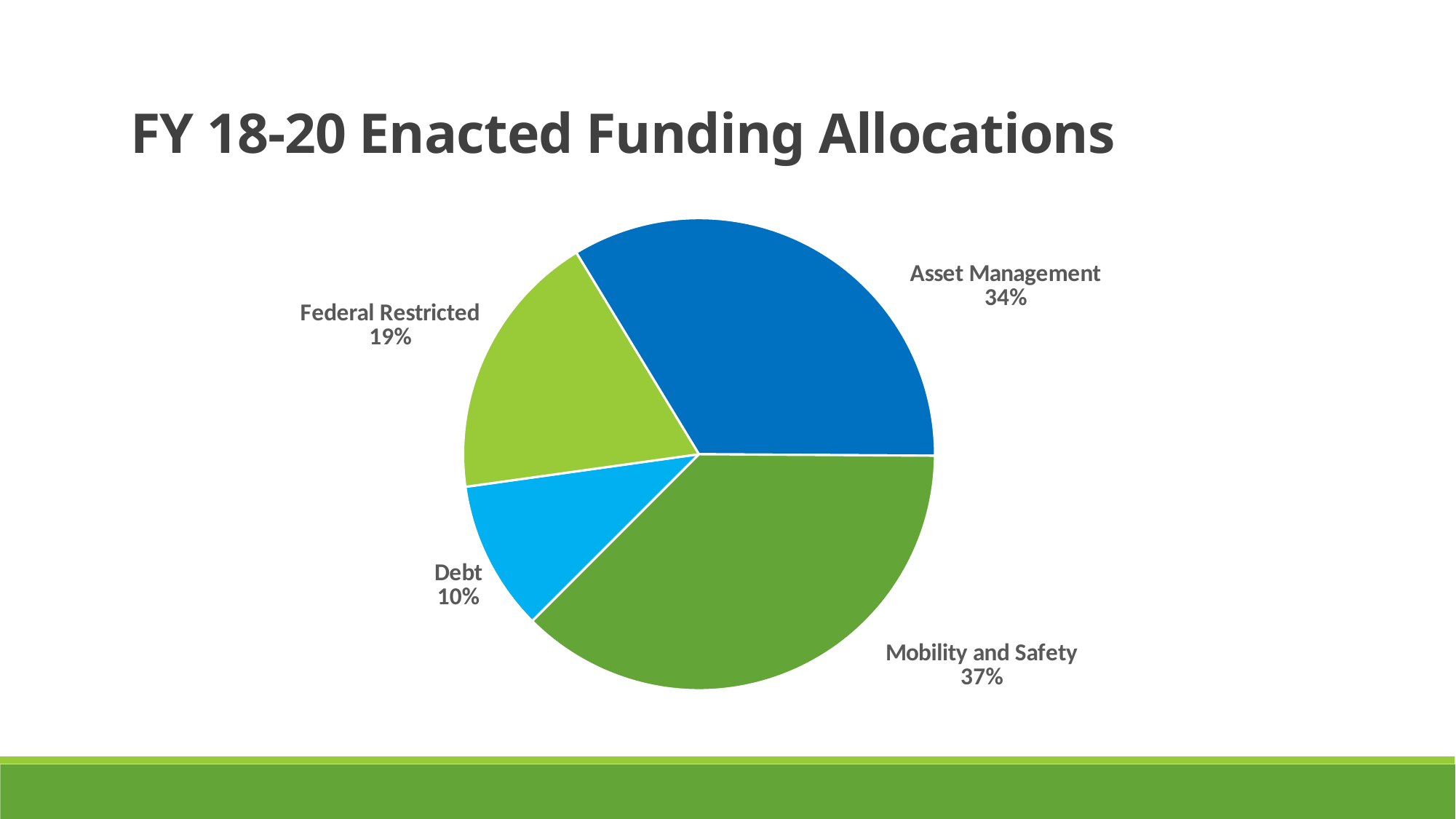
What is the difference in percentage points between Mobility and Safety and Asset Management? 3 What is the value shown for Federal Restricted? 19% Which category has the largest slice of the pie? Mobility and Safety What is the difference in percentage points between Federal Restricted and Debt? 9 What kind of chart is shown on the slide? Pie chart What is the title of the slide? FY 18-20 Enacted Funding Allocations Which is larger, Federal Restricted or Debt? Federal Restricted What is the value shown for Mobility and Safety? 37% What is the value shown for Debt? 10% How many categories are shown in the pie chart? 4 What share of the pie does Asset Management represent? 34% Which category has the smallest slice of the pie? Debt